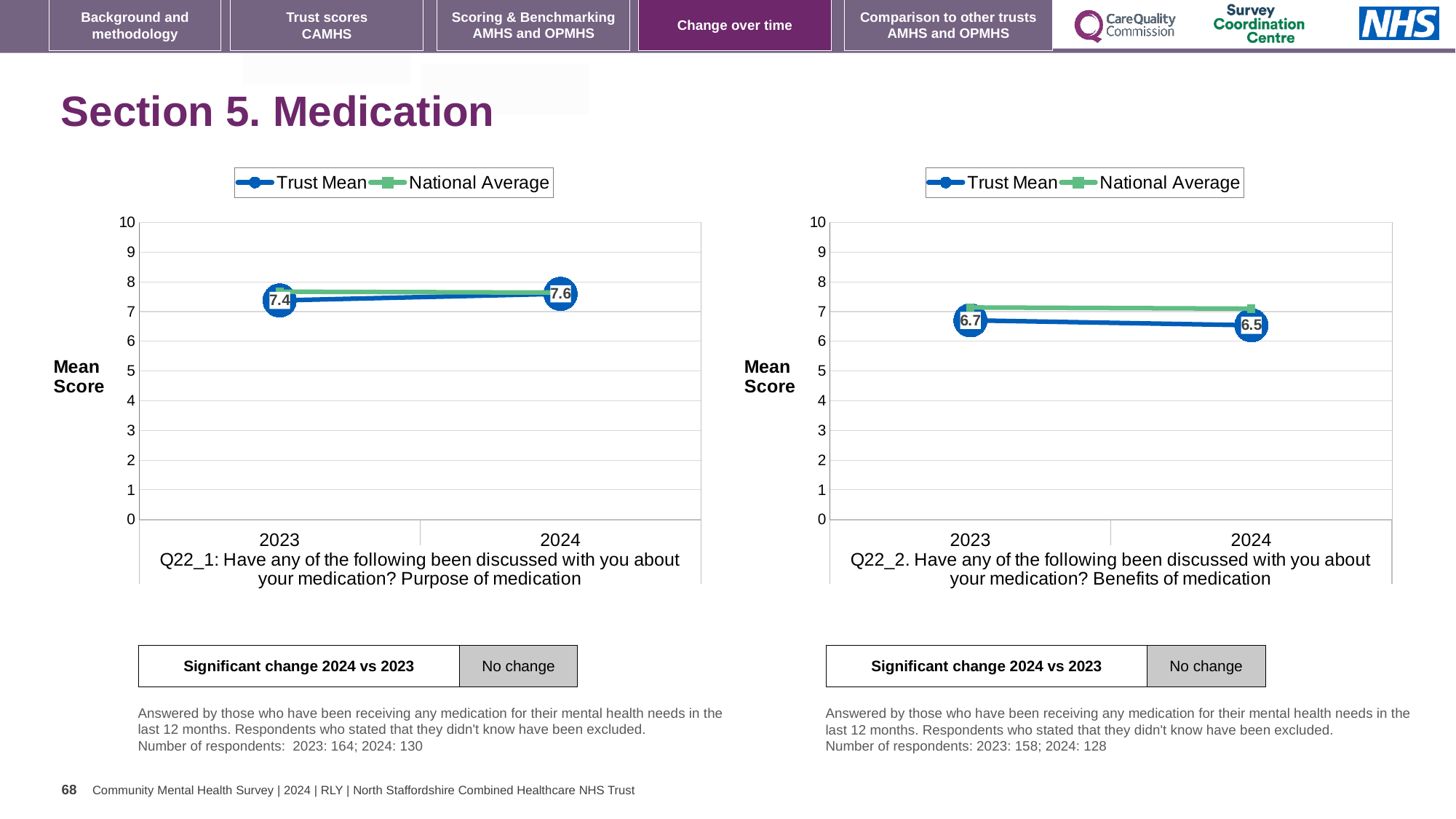
In the left chart (Q22_1: Purpose of medication), does the Trust Mean rise or fall from 2023 to 2024? rise In the right chart (Q22_2: Benefits of medication), which is higher in 2023, the Trust Mean or the National Average? National Average What type of chart is used for Q22_1: Purpose of medication? line chart In the right chart (Q22_2: Benefits of medication), what is the difference between the Trust Mean in 2023 and 2024? 0.2 In the right chart (Q22_2: Benefits of medication), what is the Trust Mean for 2023? 6.7 In the right chart (Q22_2: Benefits of medication), does the Trust Mean rise or fall from 2023 to 2024? fall In the left chart (Q22_1: Purpose of medication), what is the Trust Mean for 2024? 7.6 In the left chart (Q22_1: Purpose of medication), by how much did the Trust Mean change from 2023 to 2024? 0.2 How many series does the legend of the right chart (Q22_2: Benefits of medication) list? 2 In the right chart (Q22_2: Benefits of medication), what is the Trust Mean for 2024? 6.5 In the left chart (Q22_1: Purpose of medication), what is the Trust Mean for 2023? 7.4